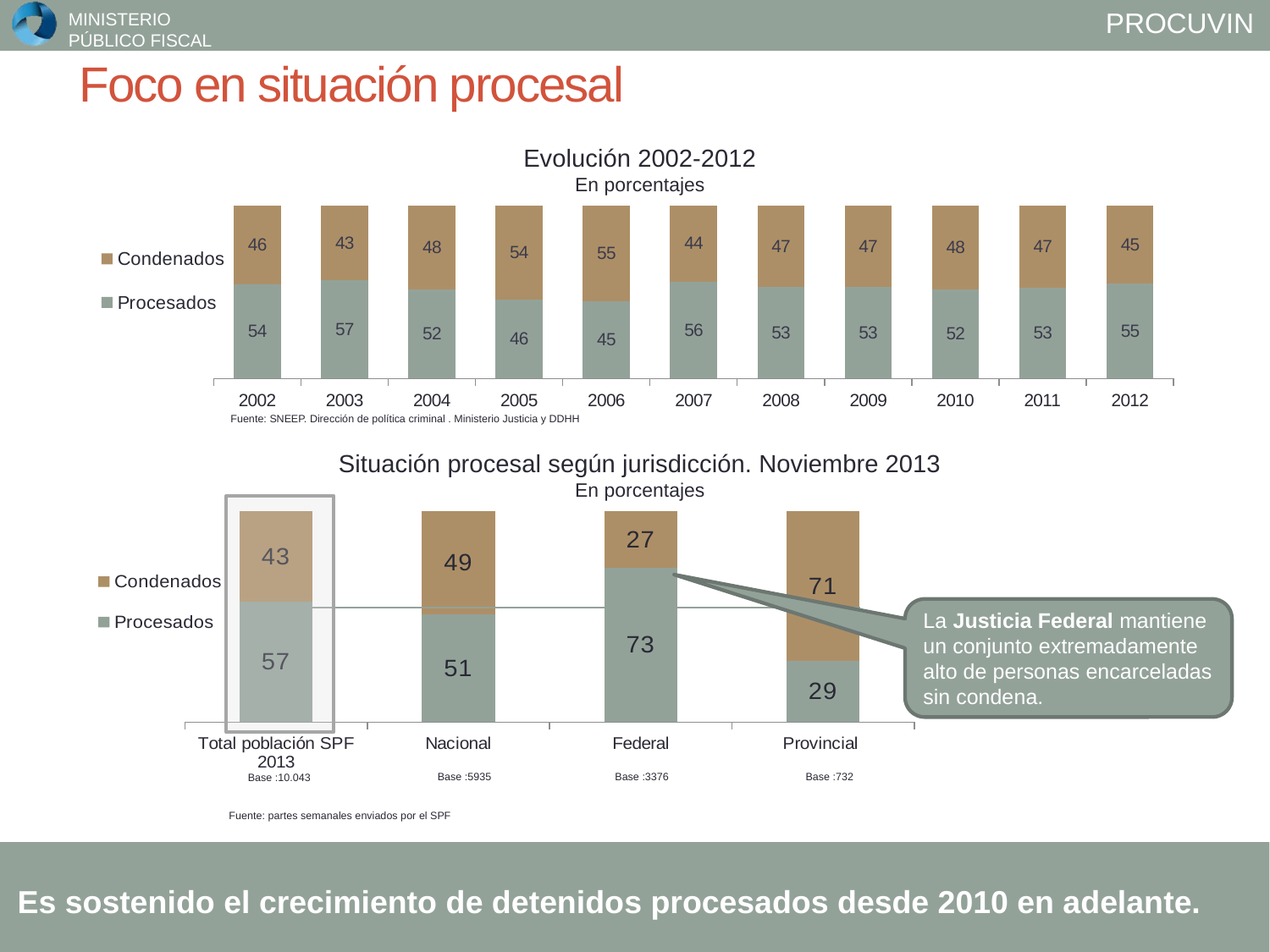
In the 'Situación procesal según jurisdicción. Noviembre 2013' chart, which is larger: Procesados in Nacional or Procesados in Federal? Federal In the 'Evolución 2002-2012' chart, what is the total of the stacked bar for 2008? 100 In the 'Evolución 2002-2012' chart, which year has the highest value for Procesados? 2003 In the 'Situación procesal según jurisdicción. Noviembre 2013' chart, what is the difference between Condenados and Procesados in Provincial? 42 In the 'Situación procesal según jurisdicción. Noviembre 2013' chart, which jurisdiction has the highest value for Condenados? Provincial What type of chart is the 'Situación procesal según jurisdicción. Noviembre 2013' chart? Stacked bar chart In the 'Evolución 2002-2012' chart, what is the value for Procesados in 2006? 45 In the 'Situación procesal según jurisdicción. Noviembre 2013' chart, what is the value for Procesados in Federal? 73 In the 'Evolución 2002-2012' chart, what is the difference between Procesados and Condenados in 2012? 10 In the 'Evolución 2002-2012' chart, how many years are shown on the x axis? 11 In the 'Evolución 2002-2012' chart, what is the value for Condenados in 2005? 54 In the 'Evolución 2002-2012' chart, which year has the lowest value for Condenados? 2003